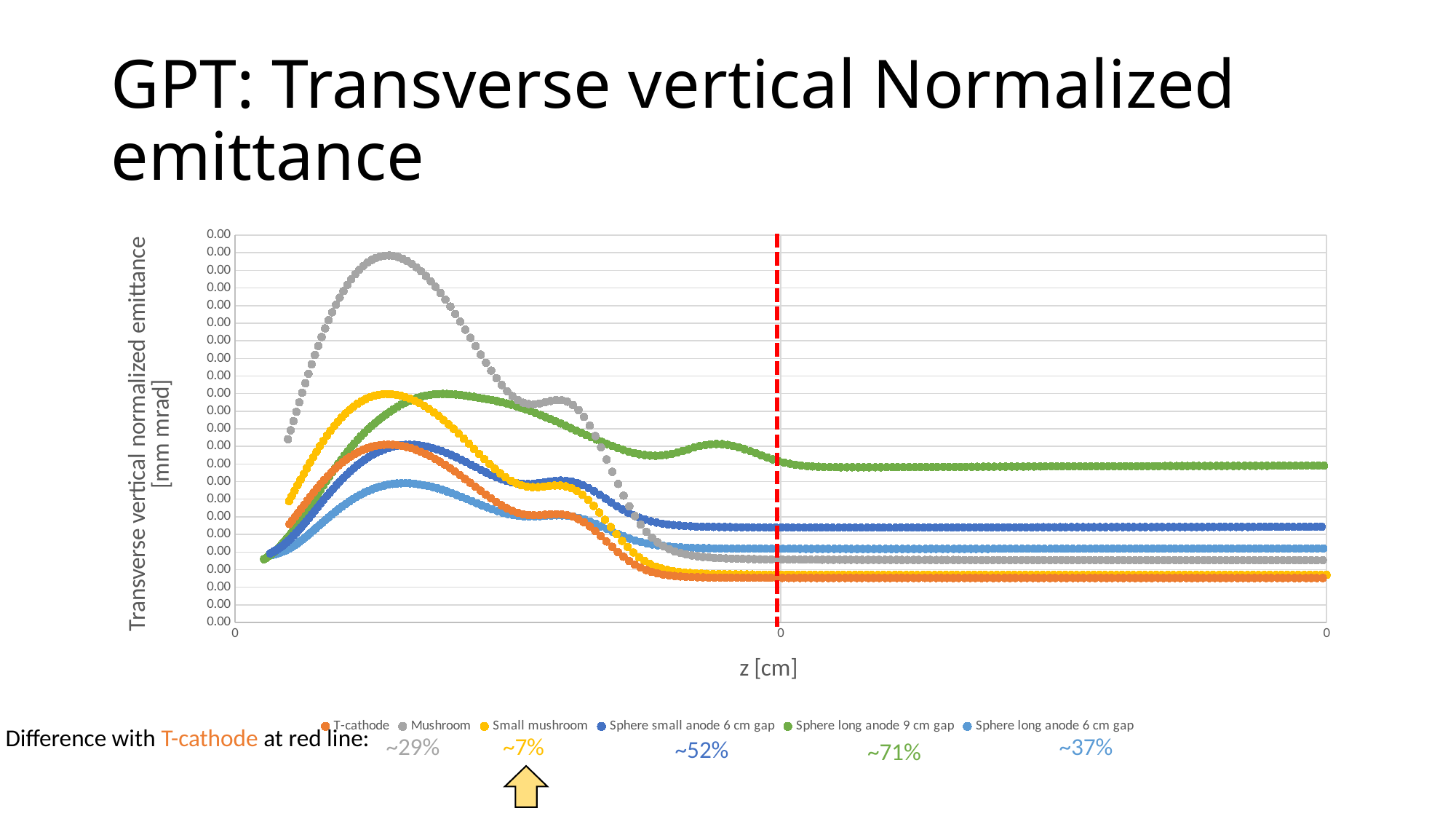
What kind of chart is shown on the slide? scatter chart How many series does the chart legend list? 6 What is the title of the y axis? Transverse vertical normalized emittance [mm mrad] Which series has the highest value at the far right end of the chart? Sphere long anode 9 cm gap At the right end of the chart, which is higher: Sphere small anode 6 cm gap or Sphere long anode 6 cm gap? Sphere small anode 6 cm gap At the right end of the chart, does the Mushroom series sit above or below the Sphere long anode 6 cm gap series? below What is the title of the x axis? z [cm] Which series has the higher peak: Small mushroom or T-cathode? Small mushroom How does the Mushroom series behave along the x axis before it flattens out? rises then falls Which series reaches the highest peak value on the chart? Mushroom Which series has the lowest peak value on the chart? Sphere long anode 6 cm gap